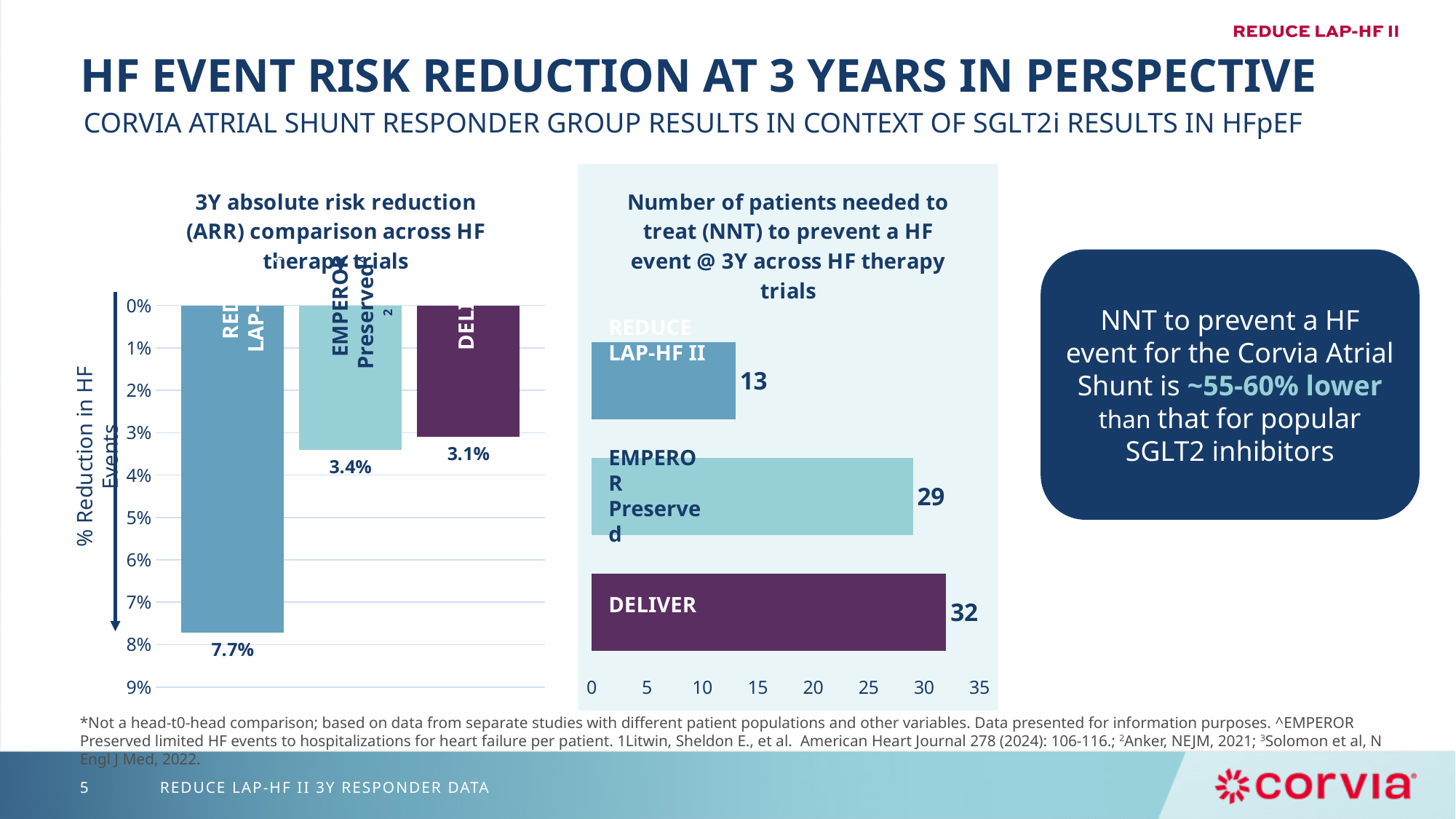
In the number of patients needed to treat (NNT) chart, what is the value for REDUCE LAP-HF II? 13 In the number of patients needed to treat (NNT) chart, which trial has the lowest NNT? REDUCE LAP-HF II In the 3Y absolute risk reduction (ARR) chart, how many bars are plotted? 3 In the 3Y absolute risk reduction (ARR) chart, what is the value for REDUCE LAP-HF II? 7.7% In the 3Y absolute risk reduction (ARR) chart, what is the difference between the REDUCE LAP-HF II and EMPEROR Preserved values? 4.3% What kind of chart is the number of patients needed to treat (NNT) chart? Bar chart In the number of patients needed to treat (NNT) chart, what is the value for EMPEROR Preserved? 29 In the 3Y absolute risk reduction (ARR) chart, which trial has the largest risk reduction? REDUCE LAP-HF II In the 3Y absolute risk reduction (ARR) chart, what is the value for DELIVER? 3.1% In the number of patients needed to treat (NNT) chart, what is the difference between the DELIVER and REDUCE LAP-HF II values? 19 In the number of patients needed to treat (NNT) chart, what is the value for DELIVER? 32 In the 3Y absolute risk reduction (ARR) chart, what is the value for EMPEROR Preserved? 3.4%